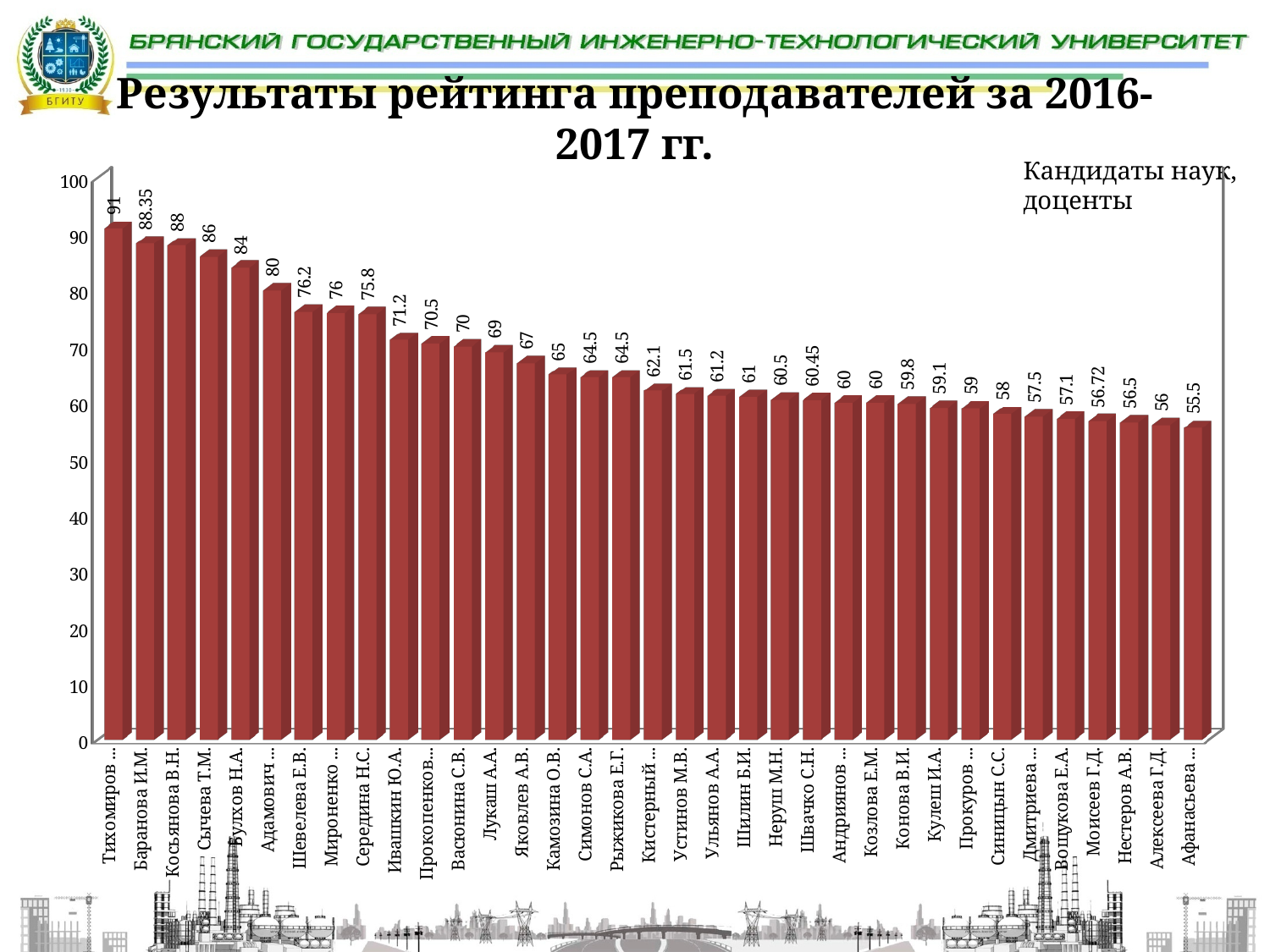
Which lecturer has the highest rating on the chart? Тихомиров What is the rating value for Сычева Т.М.? 86 Do the values rise or fall from left to right along the x axis? Fall What is the rating value for Баранова И.М.? 88.35 Which lecturer has the lowest rating on the chart? Афанасьева What type of chart is shown on the slide? Bar chart What is the difference between the ratings of Баранова И.М. and Косьянова В.Н.? 0.35 Who has the higher rating, Лукаш А.А. or Яковлев А.В.? Лукаш А.А. What group of lecturers does the chart cover, according to the note in the top right corner? Кандидаты наук, доценты What is the rating value for Швачко С.Н.? 60.45 What is the rating value for Моисеев Г.Д.? 56.72 How many lecturers are shown on the chart? 35